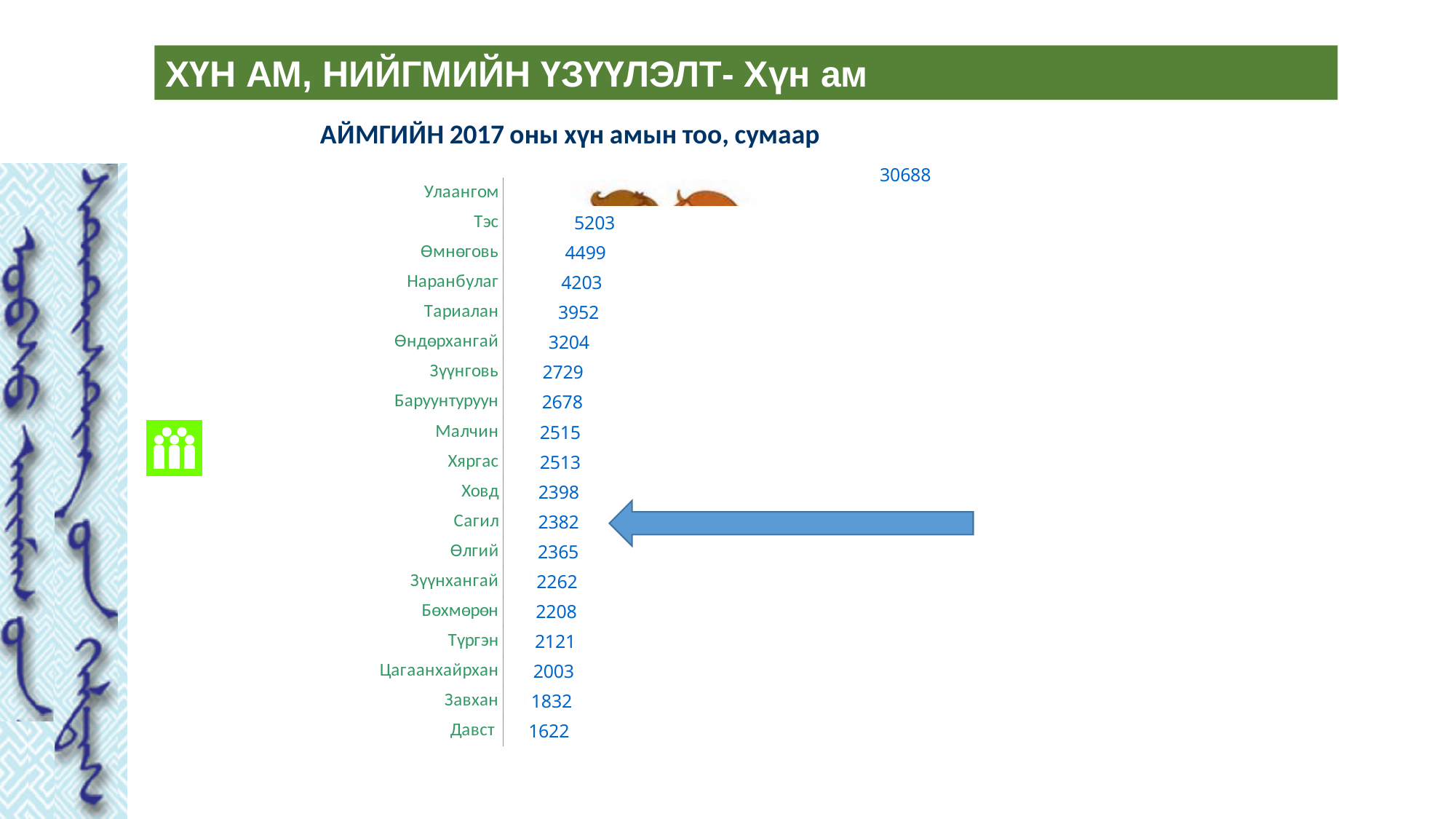
What is the value shown for Тэс? 5203 What is the value shown for Давст? 1622 What is the population value shown for Улаангом? 30688 What is the value shown for Сагил, the category marked with the arrow? 2382 What is the title of the chart? АЙМГИЙН 2017 оны хүн амын тоо, сумаар How many categories (sums) are listed on the chart? 19 Which category has the lowest value on the chart? Давст Which category has the highest value on the chart? Улаангом Do the values rise or fall going down the list from Улаангом to Давст? fall What is the difference between the values for Улаангом and Давст? 29066 Which has a larger value, Наранбулаг or Тариалан? Наранбулаг What is the difference between the values for Тэс and Өмнөговь? 704